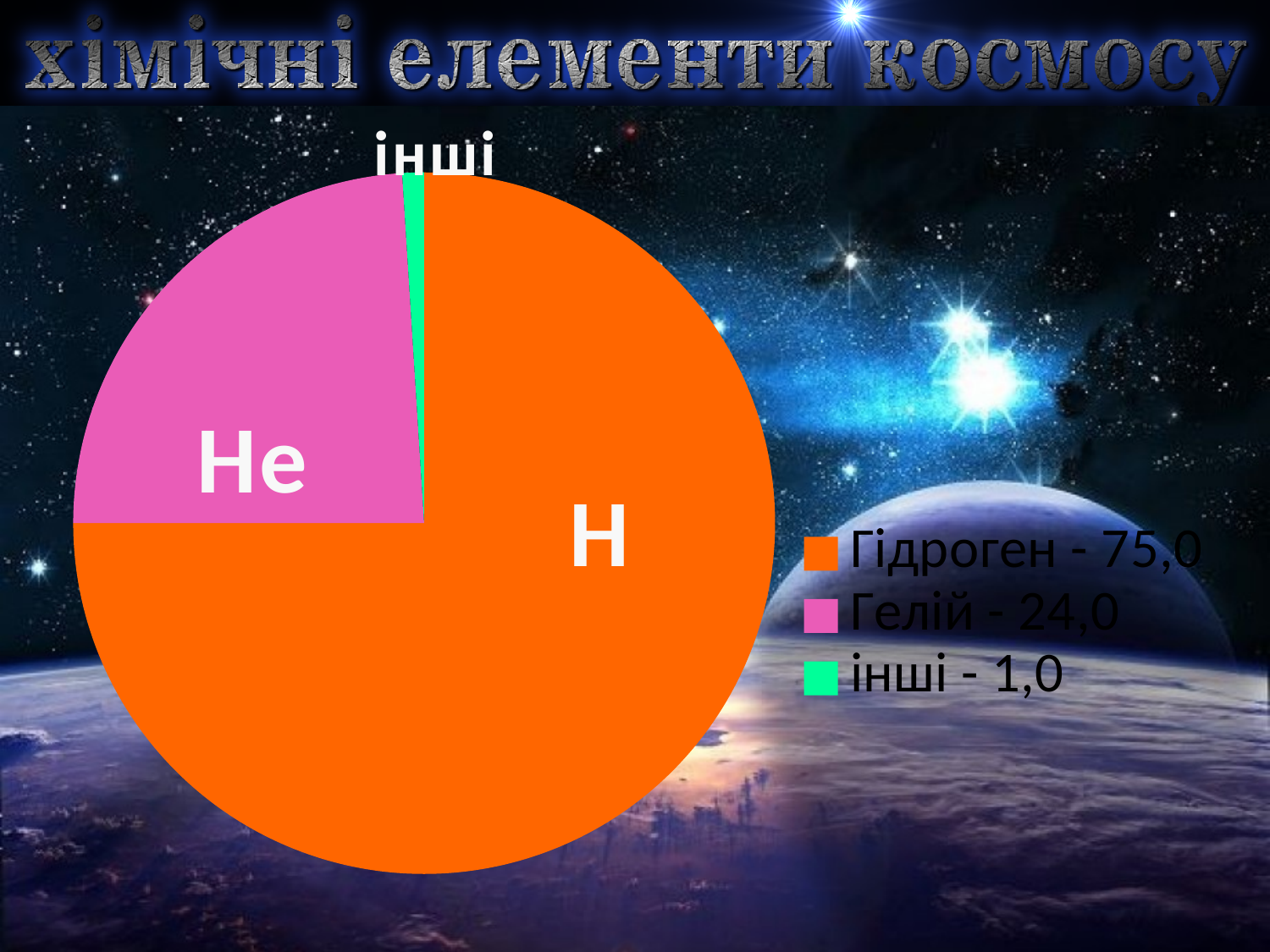
Which slice of the pie chart is the smallest? інші What value does the legend give for Гідроген? 75,0 Which is larger, the value for Гелій or the value for інші? Гелій What value does the legend give for Гелій? 24,0 What kind of chart is shown on the slide? pie chart How many entries does the legend list? 3 What colour is the slice for Гелій? pink What is the difference between the values for Гідроген and Гелій? 51,0 How many slices does the pie chart have? 3 Which slice of the pie chart is the largest? Гідроген What value does the legend give for інші? 1,0 What is the title of the slide containing the pie chart? хімічні елементи космосу